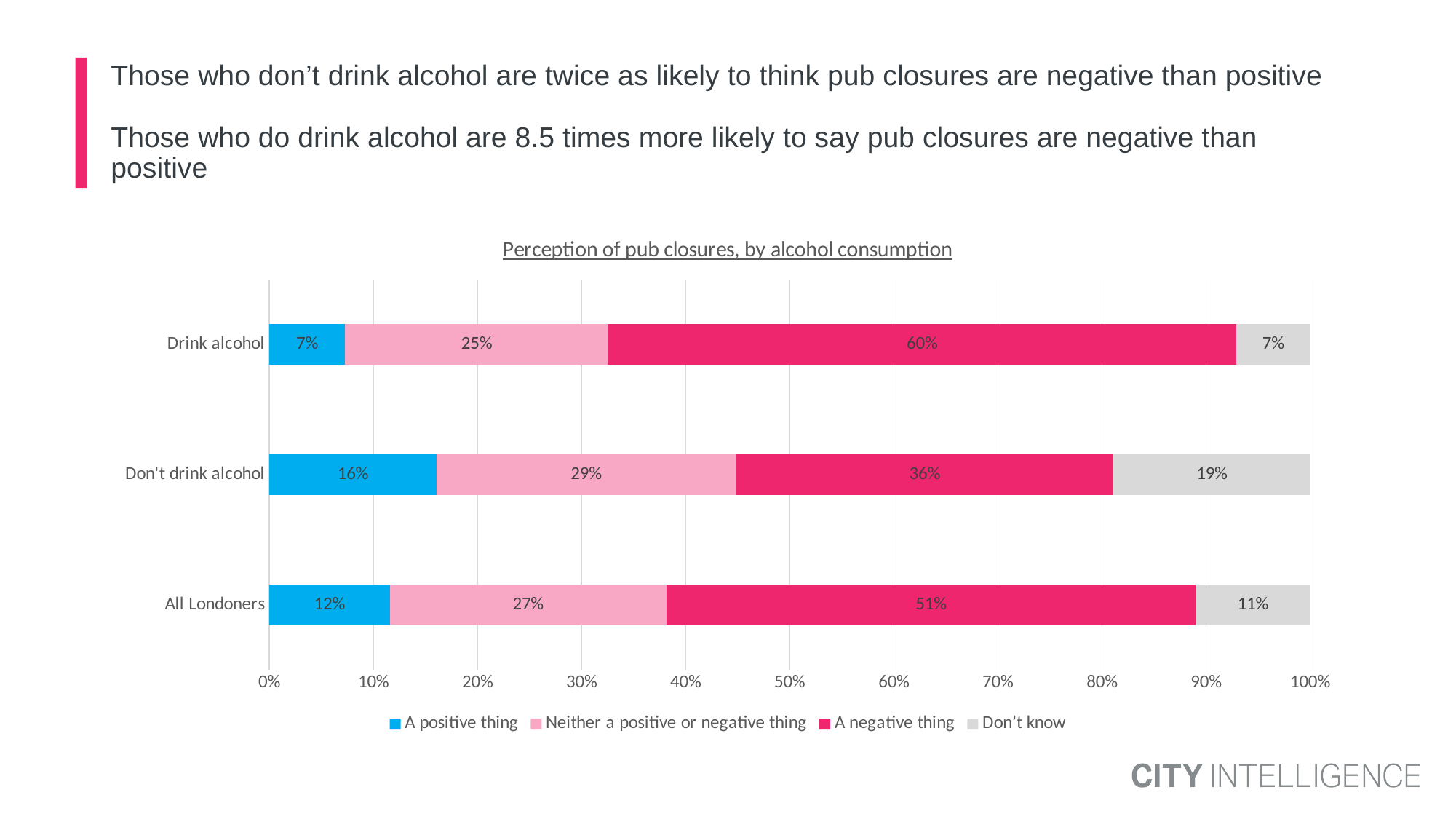
Which group has the highest share saying pub closures are a negative thing? Drink alcohol What is the difference between the 'A negative thing' share for those who drink alcohol and those who don't drink alcohol? 24 percentage points What percentage of those who don't drink alcohol say pub closures are neither a positive or negative thing? 29% What percentage of those who don't drink alcohol say pub closures are a positive thing? 16% Is the 'Don't know' share larger for those who don't drink alcohol or for All Londoners? Don't drink alcohol What kind of chart is shown on the slide? Stacked bar chart Which group has the lowest share saying pub closures are a positive thing? Drink alcohol How many series does the legend list? 4 What is the title of the chart? Perception of pub closures, by alcohol consumption What percentage of All Londoners answered 'Don't know'? 11% How many groups (categories) are shown on the chart? 3 What percentage of those who drink alcohol say pub closures are a negative thing? 60%